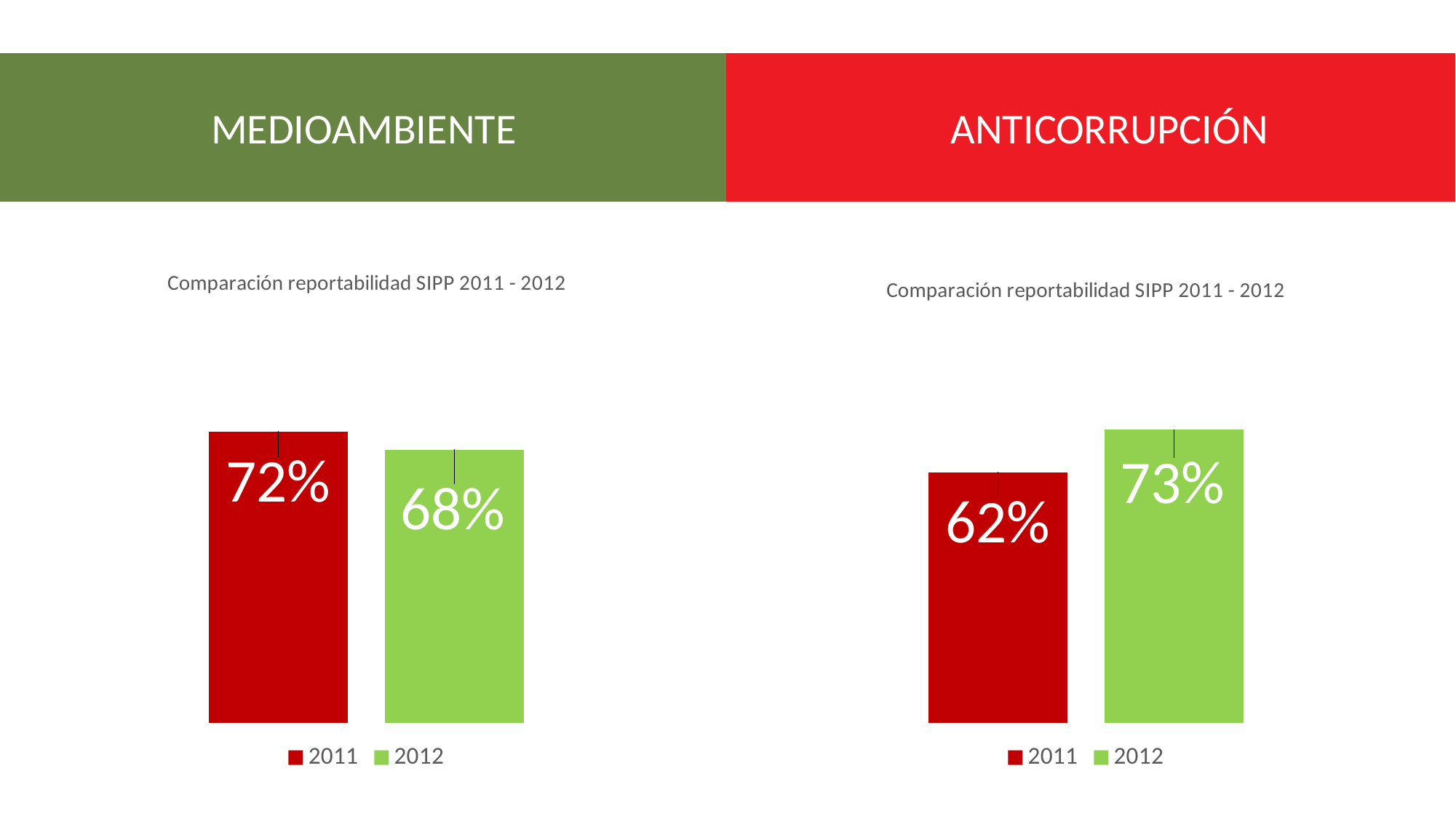
In the MEDIOAMBIENTE chart on the left, what is the difference between the 2011 and 2012 values? 4% In the MEDIOAMBIENTE chart on the left, which year has the higher value? 2011 In the ANTICORRUPCIÓN chart on the right, which year has the lower value? 2011 How many series does the legend of the ANTICORRUPCIÓN chart on the right list? 2 What kind of chart is shown under MEDIOAMBIENTE on the left? bar chart In the ANTICORRUPCIÓN chart on the right, is the value for 2012 larger or smaller than the value for 2011? larger In the MEDIOAMBIENTE chart on the left, do the values rise or fall from 2011 to 2012? fall In the ANTICORRUPCIÓN chart on the right, what is the value for 2011? 62% In the ANTICORRUPCIÓN chart on the right, what is the difference between the 2012 and 2011 values? 11% In the ANTICORRUPCIÓN chart on the right, what is the value for 2012? 73% In the MEDIOAMBIENTE chart on the left, what is the value for 2011? 72% In the MEDIOAMBIENTE chart on the left, what is the value for 2012? 68%